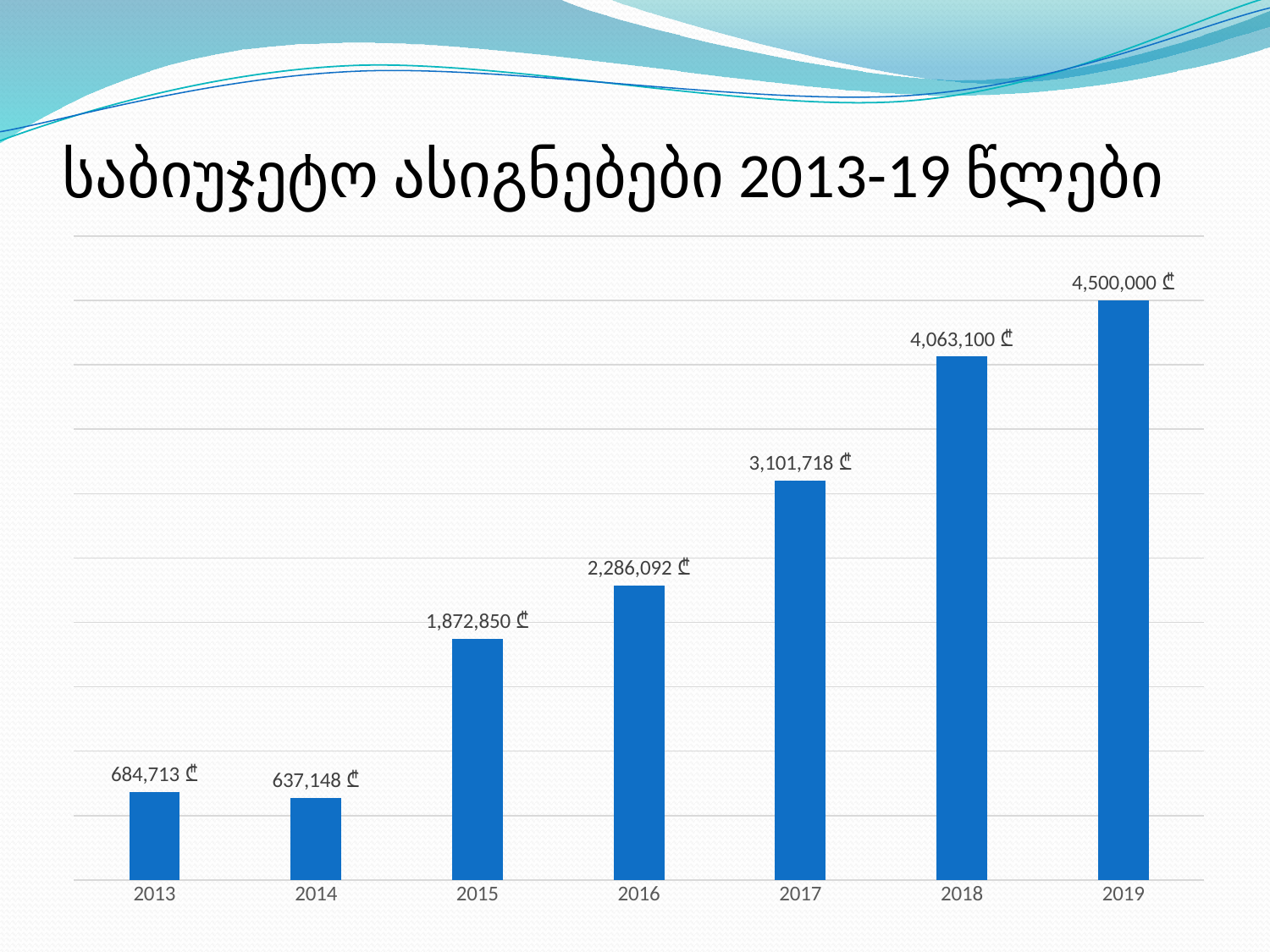
How many years are shown on the x axis? 7 What is the value for 2013? 684,713 ₾ Do the values generally rise or fall from 2014 to 2019? Rise What kind of chart is shown on the slide? Bar chart What is the title of the chart? საბიუჯეტო ასიგნებები 2013-19 წლები What is the difference between the values for 2016 and 2015? 413,242 ₾ What is the value for 2018? 4,063,100 ₾ What is the difference between the values for 2019 and 2018? 436,900 ₾ Which year has the highest value? 2019 Which is larger, the value for 2013 or the value for 2014? 2013 Which year has the lowest value? 2014 What is the value for 2015? 1,872,850 ₾